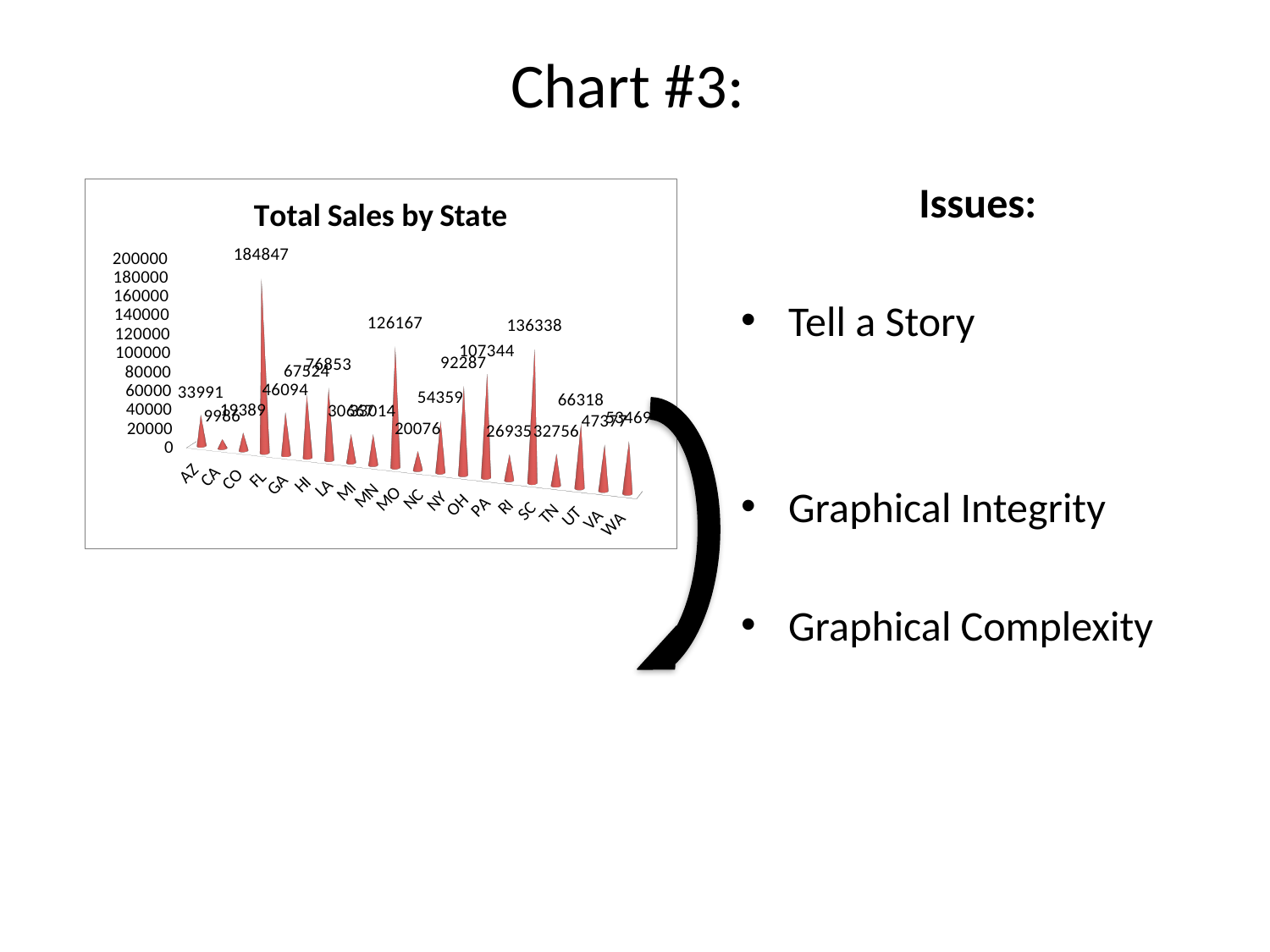
Which has higher total sales, MO or PA? MO What is the total sales value for MO? 126167 What is the difference between the total sales for FL and SC? 48509 What is the total sales value for FL? 184847 What type of chart is shown on the slide? bar chart Which state has the lowest total sales? CA What is the title of the chart? Total Sales by State How many states are shown on the x axis of the chart? 20 What is the total sales value for SC? 136338 Which state has the highest total sales? FL Is the value for GA greater or less than 60000? less What is the total sales value for NC? 20076